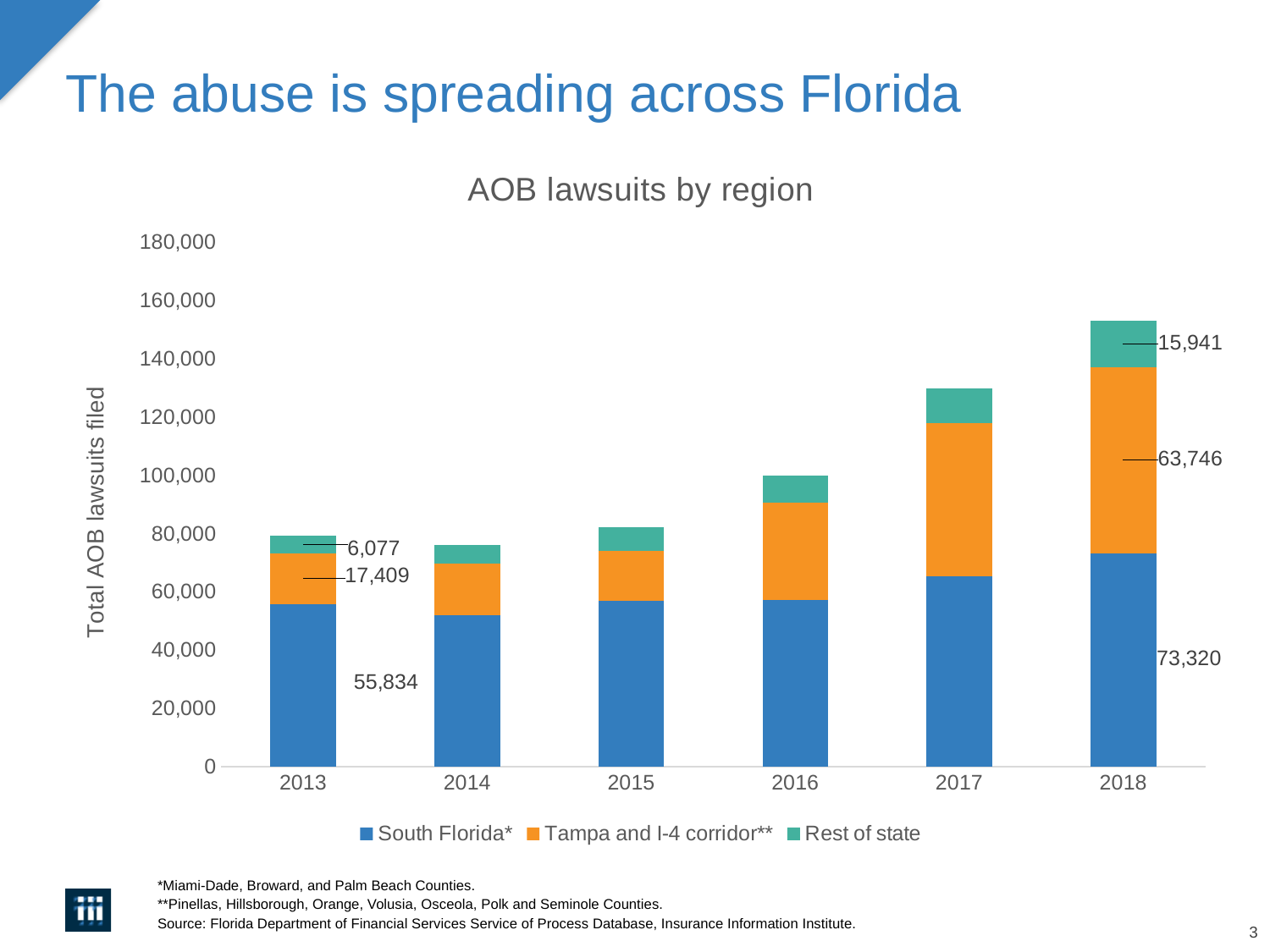
How many series does the legend list? 3 What is the value for Rest of state in 2013? 6,077 Which year has the highest total of AOB lawsuits? 2018 Is the total for 2017 greater or less than 120,000? greater What is the total number of AOB lawsuits filed in 2013? 79,320 What kind of chart is shown on the slide? stacked bar chart What is the value for Tampa and I-4 corridor in 2018? 63,746 What is the title of the chart? AOB lawsuits by region What is the total number of AOB lawsuits filed in 2018? 153,007 What is the value for South Florida in 2013? 55,834 How many years are shown on the x axis? 6 By how much did the Tampa and I-4 corridor value increase from 2013 to 2018? 46,337